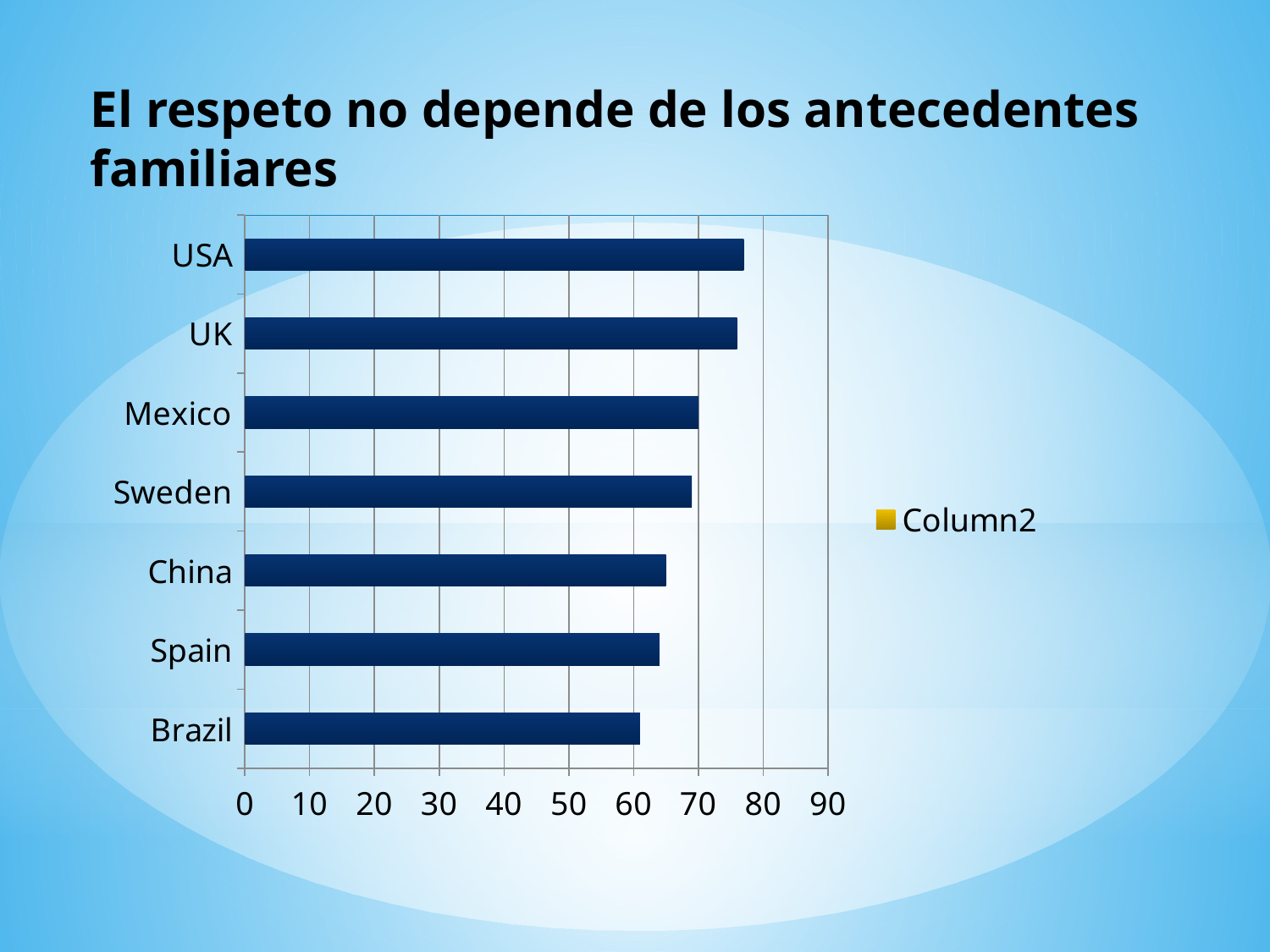
What kind of chart is shown on the slide? bar chart What is the legend entry shown next to the chart? Column2 Is the value for China greater or less than 70? less Is the value for USA greater or less than 70? greater How many series does the legend list? 1 How many countries are shown in the chart? 7 Which has the larger value, USA or Brazil? USA Is the value for Brazil greater or less than 70? less Which has the larger value, Mexico or China? Mexico What is the title of the slide containing the chart? El respeto no depende de los antecedentes familiares